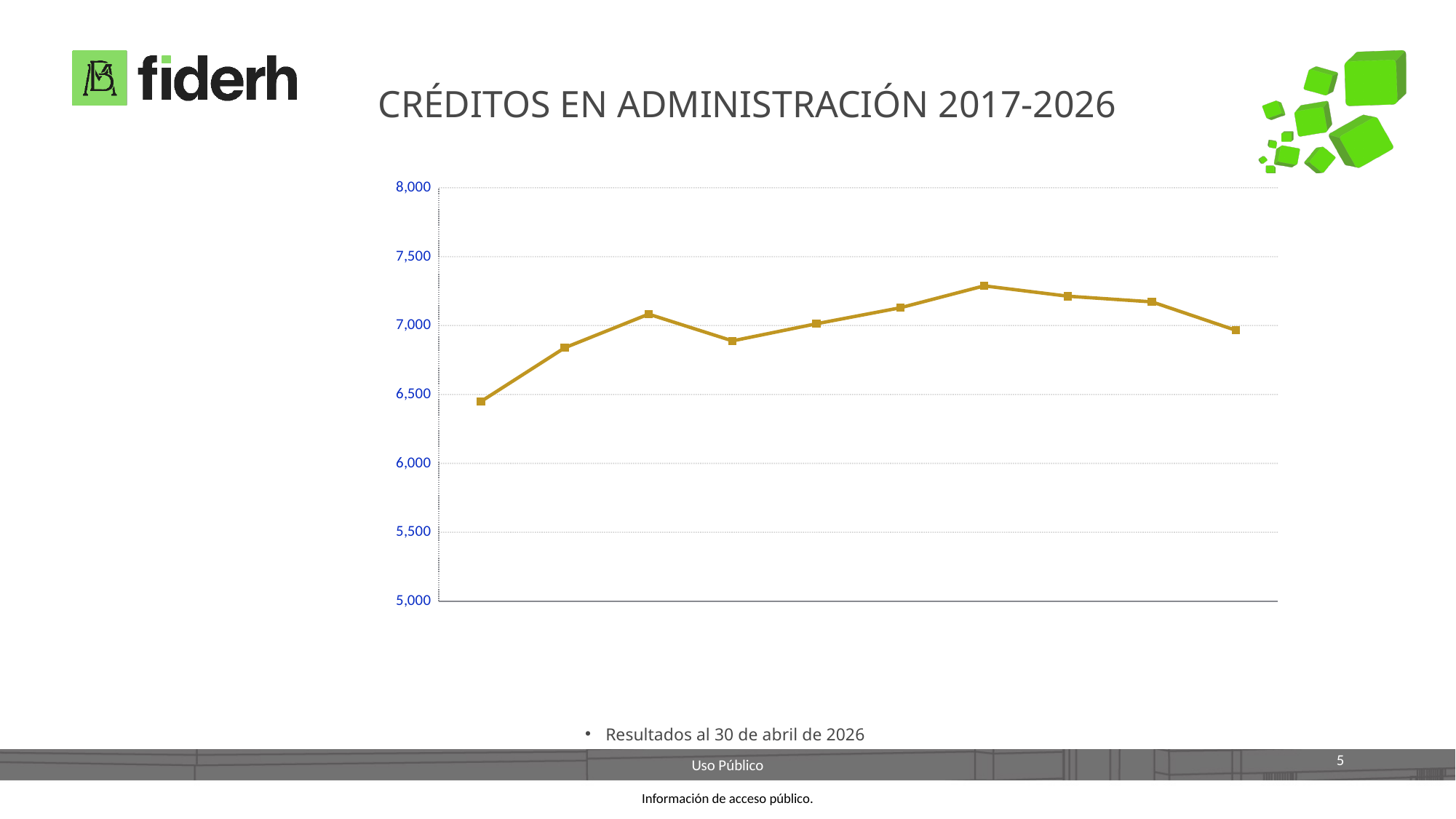
Is the value of the highest point greater or less than 7,500? less Which data point on the line is the highest? the seventh point How many data points are plotted on the line? 10 Which is larger, the value of the first point or the value of the last point? the last point What is the title of the chart? CRÉDITOS EN ADMINISTRACIÓN 2017-2026 What is the highest value shown on the vertical axis? 8,000 Does the line rise or fall between the first and second points? rise What kind of chart is shown on the slide? line chart Is the value of the first point greater or less than 7,000? less Which data point on the line is the lowest? the first point Is the value of the third point greater or less than 7,000? greater Which is larger, the value of the third point or the value of the fourth point? the third point